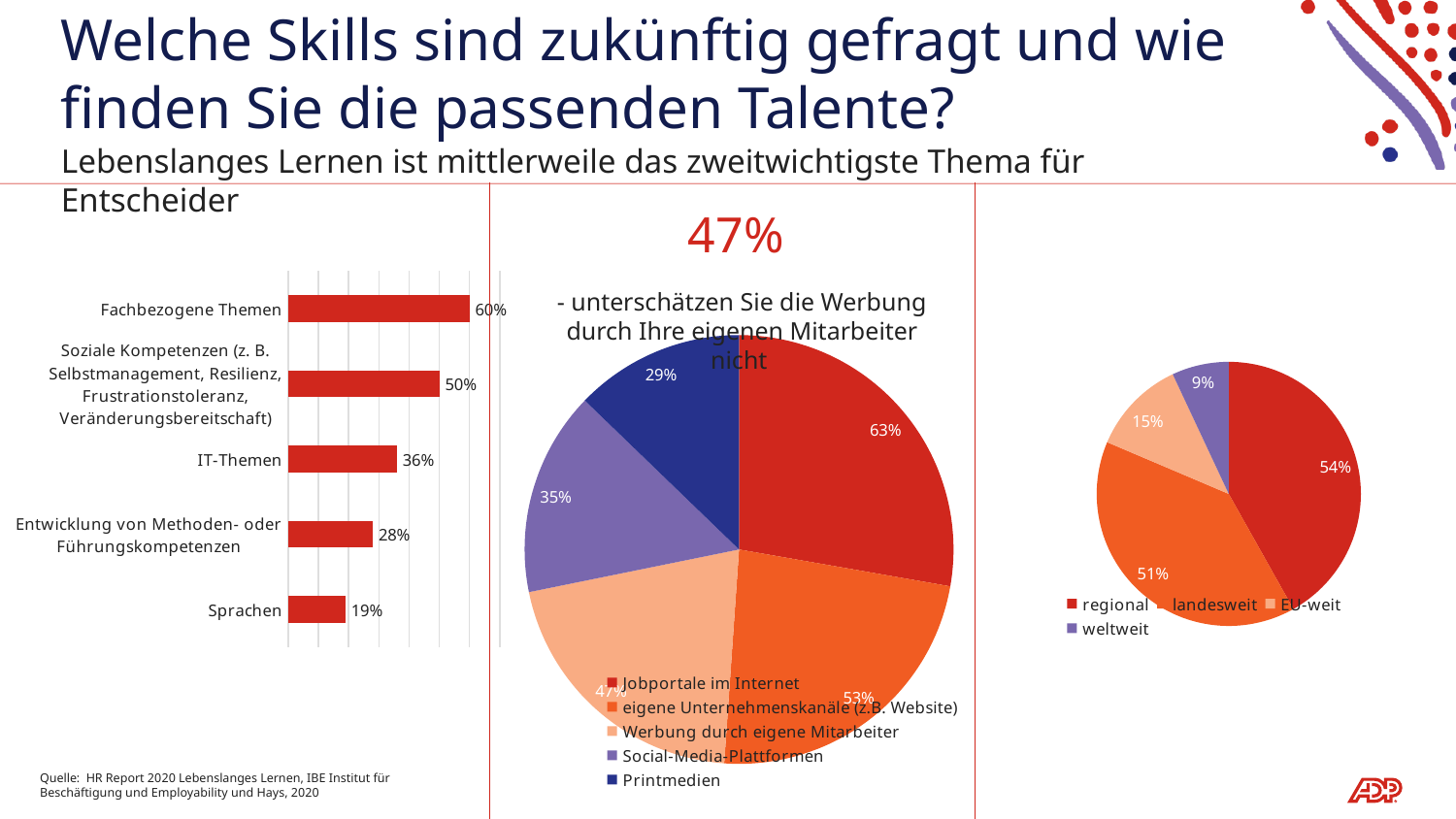
In the bar chart on the left, which category has the lowest value? Sprachen What type of chart is the chart on the left of the slide? Bar chart In the bar chart on the left, what is the value for Sprachen? 19% In the bar chart on the left, what is the value for Fachbezogene Themen? 60% In the middle pie chart, how many entries does the legend list? 5 In the pie chart on the right, which is larger, regional or weltweit? regional In the bar chart on the left, which category has the highest value? Fachbezogene Themen In the bar chart on the left, what is the difference between IT-Themen and Sprachen? 17% In the middle pie chart, what is the value for Jobportale im Internet? 63% In the bar chart on the left, how many categories are shown? 5 In the middle pie chart, what is the value for Printmedien? 29% In the pie chart on the right, what is the value for EU-weit? 15%